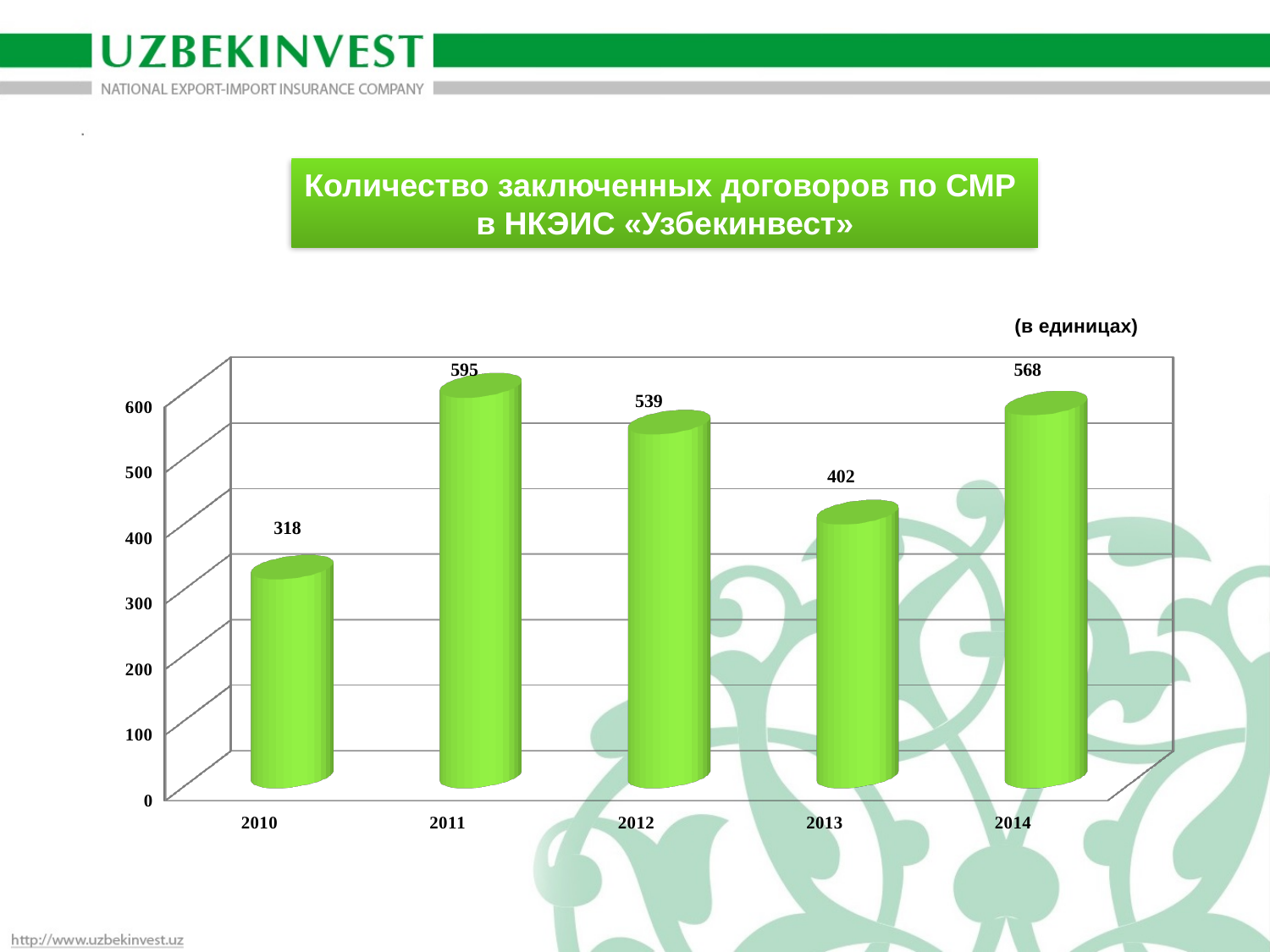
What is the difference between the values for 2011 and 2010? 277 What unit is indicated above the chart? в единицах Which year has the highest value? 2011 What is the difference between the values for 2014 and 2013? 166 What kind of chart is shown on the slide? bar chart How many years are shown on the x axis? 5 What is the value for 2013? 402 Which year has the lowest value? 2010 Is the value for 2012 greater or less than 500? greater Which is larger, the value for 2012 or the value for 2013? 2012 What is the value for 2014? 568 What is the value for 2010? 318